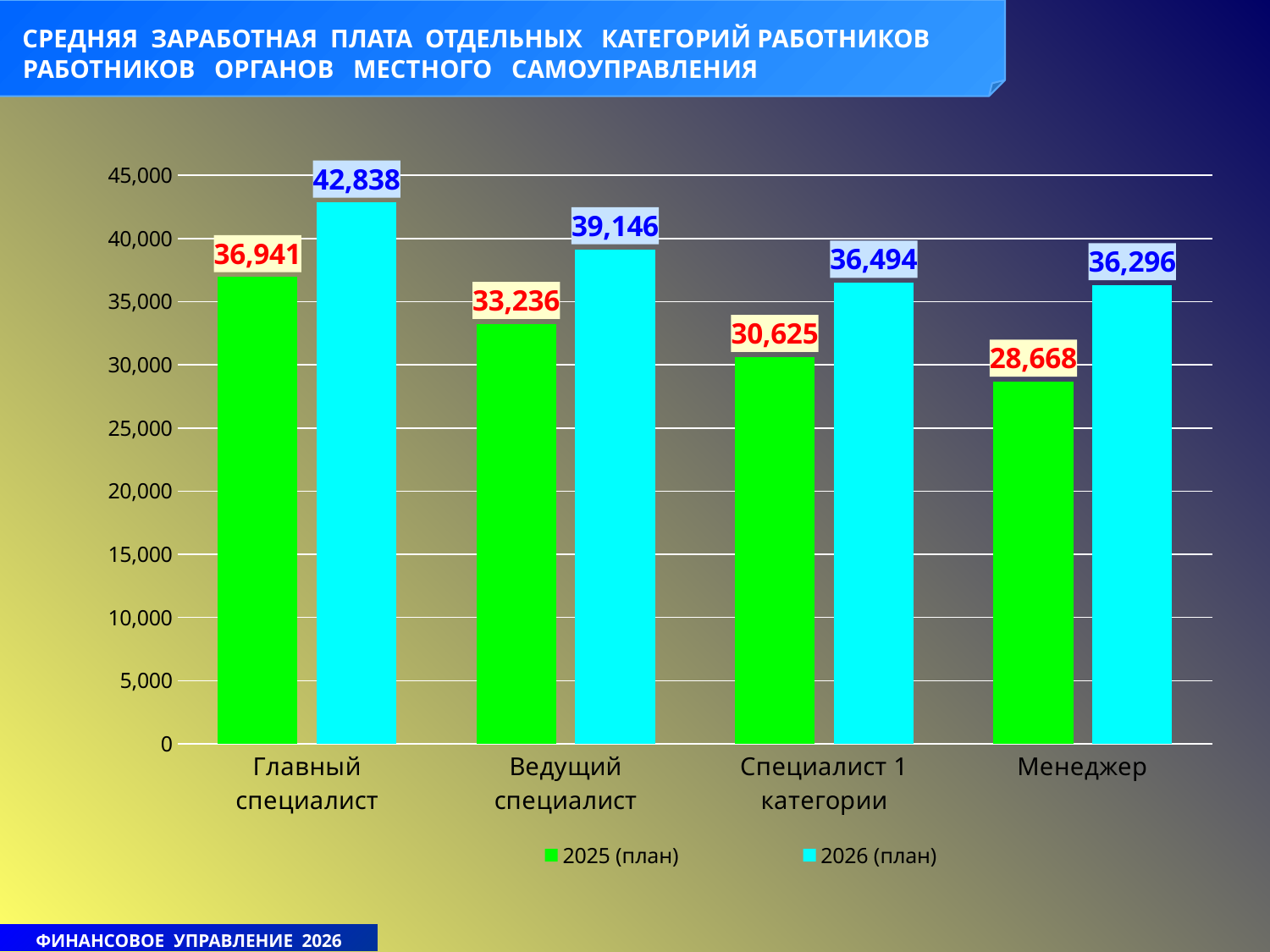
What is the 2025 (план) value for Главный специалист? 36,941 Which category has the highest 2026 (план) value? Главный специалист Which category has the lowest 2025 (план) value? Менеджер How many series does the legend list? 2 Which is larger: the 2025 (план) value for Ведущий специалист or the 2026 (план) value for Менеджер? 2026 (план) value for Менеджер What is the 2026 (план) value for Ведущий специалист? 39,146 How many categories are shown on the x axis? 4 Do the 2025 (план) values rise or fall from left to right across the categories? Fall What kind of chart is shown on the slide? Bar chart What is the difference between the 2026 (план) and 2025 (план) values for Главный специалист? 5,897 What is the 2025 (план) value for Специалист 1 категории? 30,625 What is the 2026 (план) value for Менеджер? 36,296